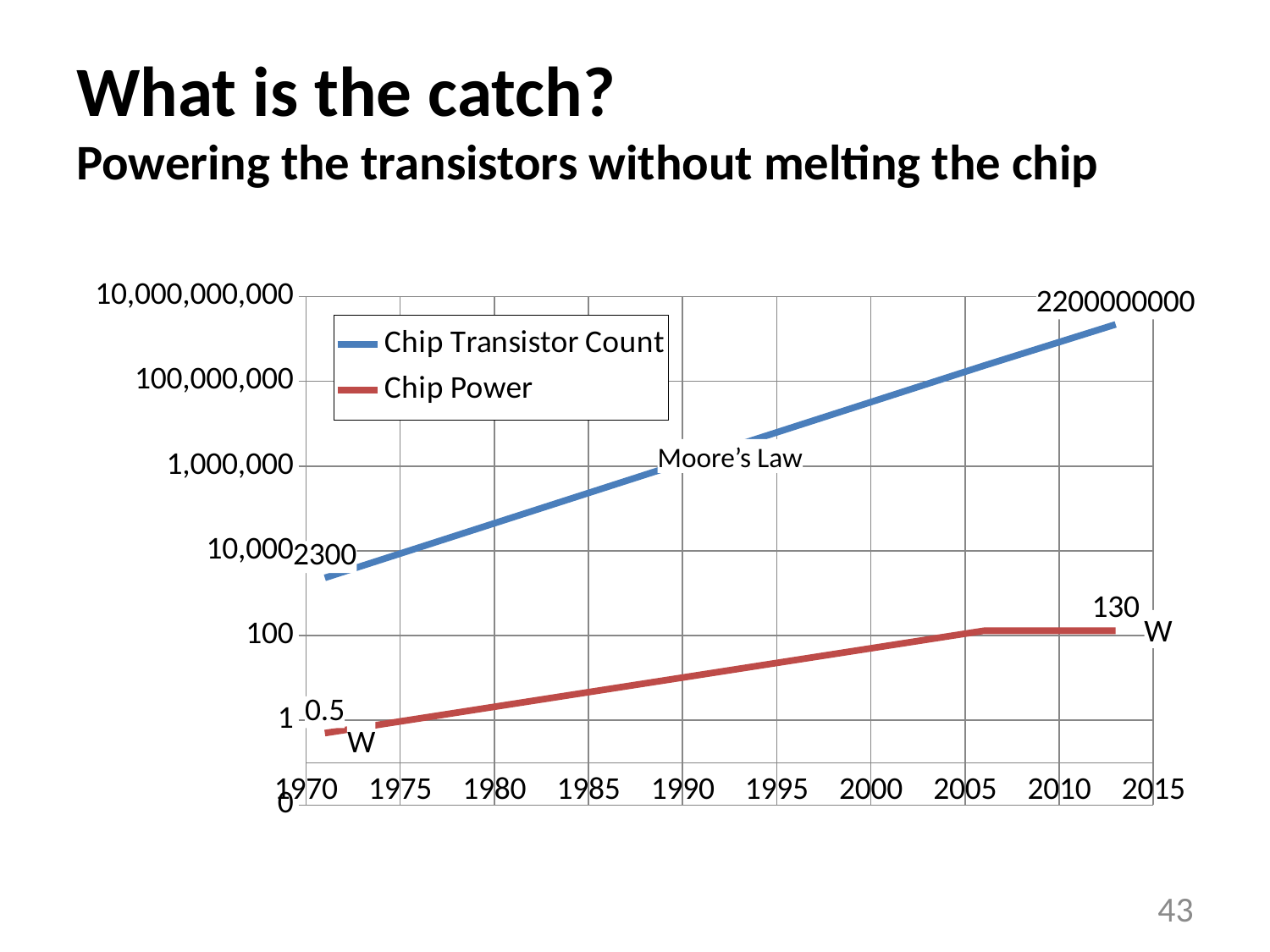
What kind of chart is shown on the slide? line chart Which series has the larger value around 2010, Chip Transistor Count or Chip Power? Chip Transistor Count What annotation text is placed next to the Chip Transistor Count line? Moore's Law What is the data label at the start of the Chip Transistor Count line? 2300 Is the Chip Transistor Count value around 2000 greater or less than 1,000,000? greater By how much does the labelled end value of Chip Power (130) exceed its labelled start value (0.5)? 129.5 Does the Chip Transistor Count line rise or fall from 1970 to 2015? rise What is the data label at the start of the Chip Power line? 0.5 Is the Chip Power value around 1990 greater or less than 100? less What is the data label at the end of the Chip Transistor Count line? 2200000000 How many series does the legend list? 2 What is the data label at the end of the Chip Power line? 130